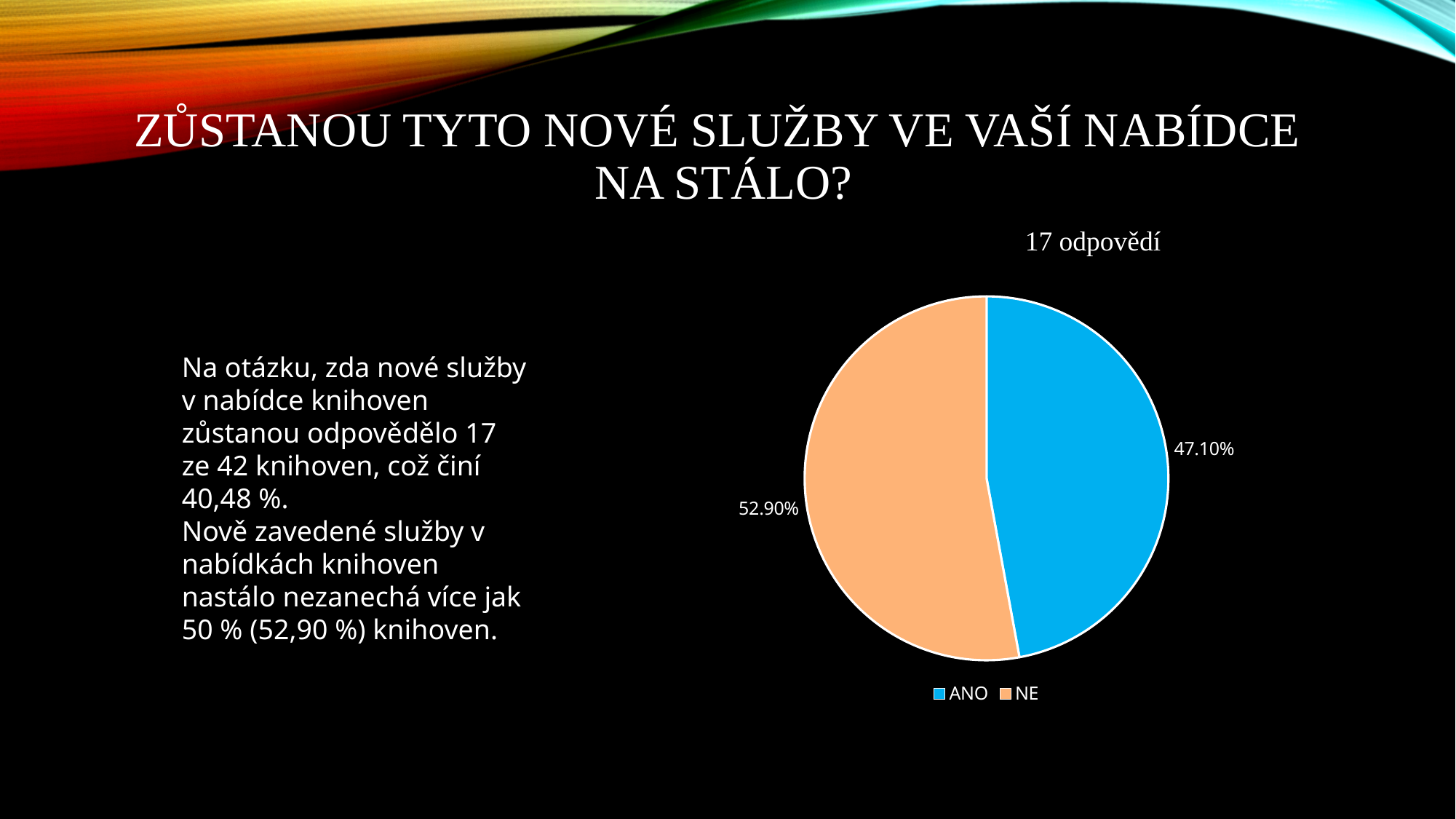
What is the share of the ANO slice in the pie chart? 47.10% How many entries does the chart legend list? 2 What is the share of the NE slice in the pie chart? 52.90% What is the difference in percentage points between the NE and ANO slices? 5.80% Which slice of the pie chart is the smallest? ANO Which is larger in the pie chart, ANO or NE? NE Is the share of the ANO slice greater or less than 50%? less How many slices does the pie chart have? 2 What colour is the ANO slice in the pie chart? blue What is the title shown above the pie chart? 17 odpovědí What kind of chart is shown on the slide? pie chart Which slice of the pie chart is the largest? NE